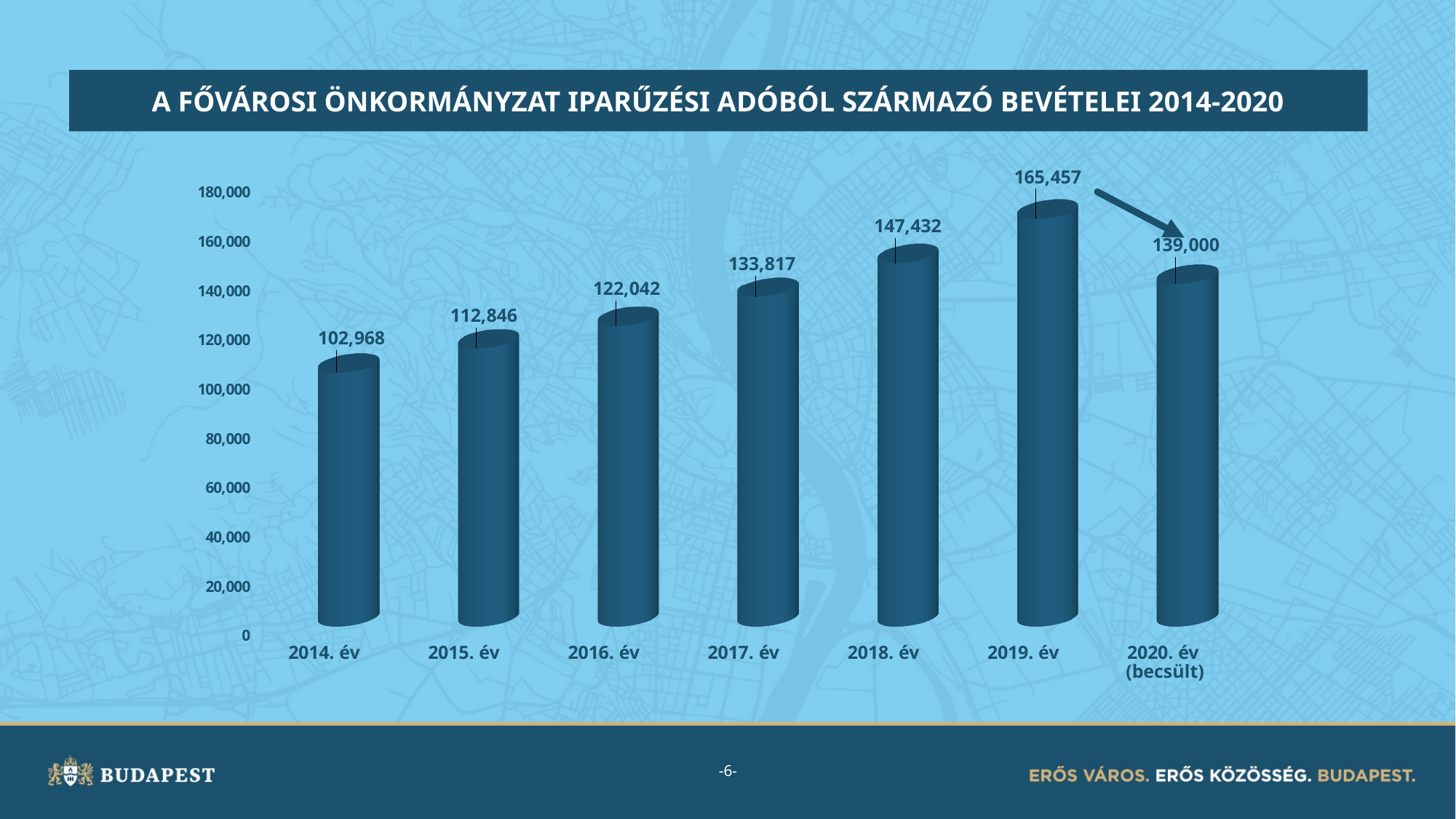
What is the value for 2019. év? 165,457 What is the difference between the values for 2019. év and 2020. év (becsült)? 26,457 What is the estimated value for 2020. év (becsült)? 139,000 How many years are shown on the chart? 7 What is the value for 2014. év? 102,968 Which year has the lowest value? 2014. év Which is larger, the value for 2016. év or the value for 2015. év? 2016. év What is the value for 2017. év? 133,817 Do the values rise or fall from 2014. év to 2019. év? Rise What kind of chart is shown on the slide? Bar chart What is the difference between the values for 2018. év and 2017. év? 13,615 Which year has the highest value? 2019. év